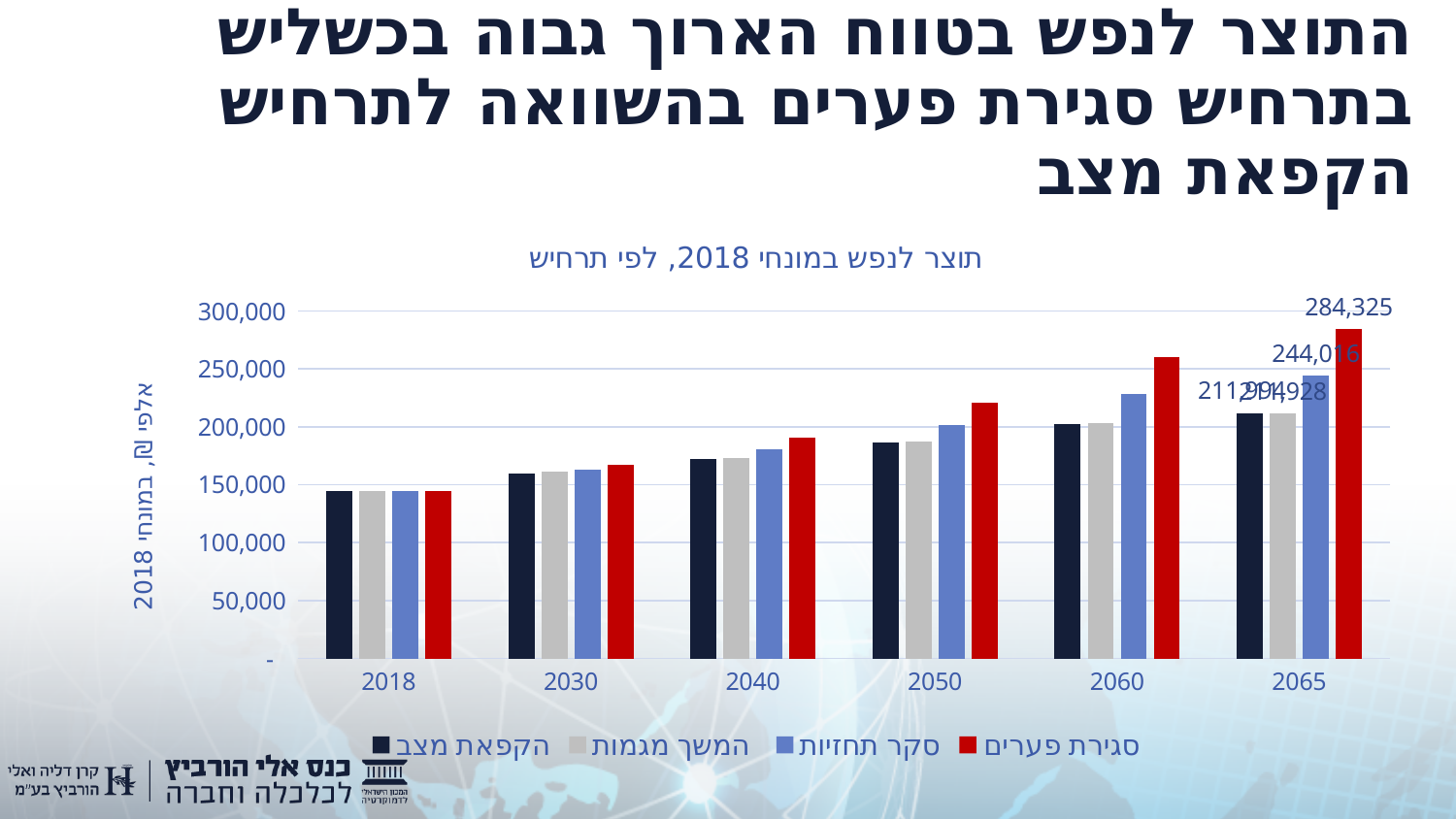
Is the value for סגירת פערים in 2060 greater or less than 250,000? greater How many series does the chart's legend list? 4 Do the values for סגירת פערים rise or fall from 2018 to 2065? rise What colour are the bars for the סגירת פערים series? red How many years (categories) are shown on the x axis of the chart? 6 In 2060, which is larger: the value for סגירת פערים or the value for הקפאת מצב? סגירת פערים Which scenario has the highest value in 2065? סגירת פערים What is the value for סגירת פערים in 2065? 284,325 Which year has the lowest values across all scenarios? 2018 What is the difference between the 2065 values for סגירת פערים and סקר תחזיות? 40,309 What kind of chart is shown on the slide? bar chart What is the value for סקר תחזיות in 2065? 244,016